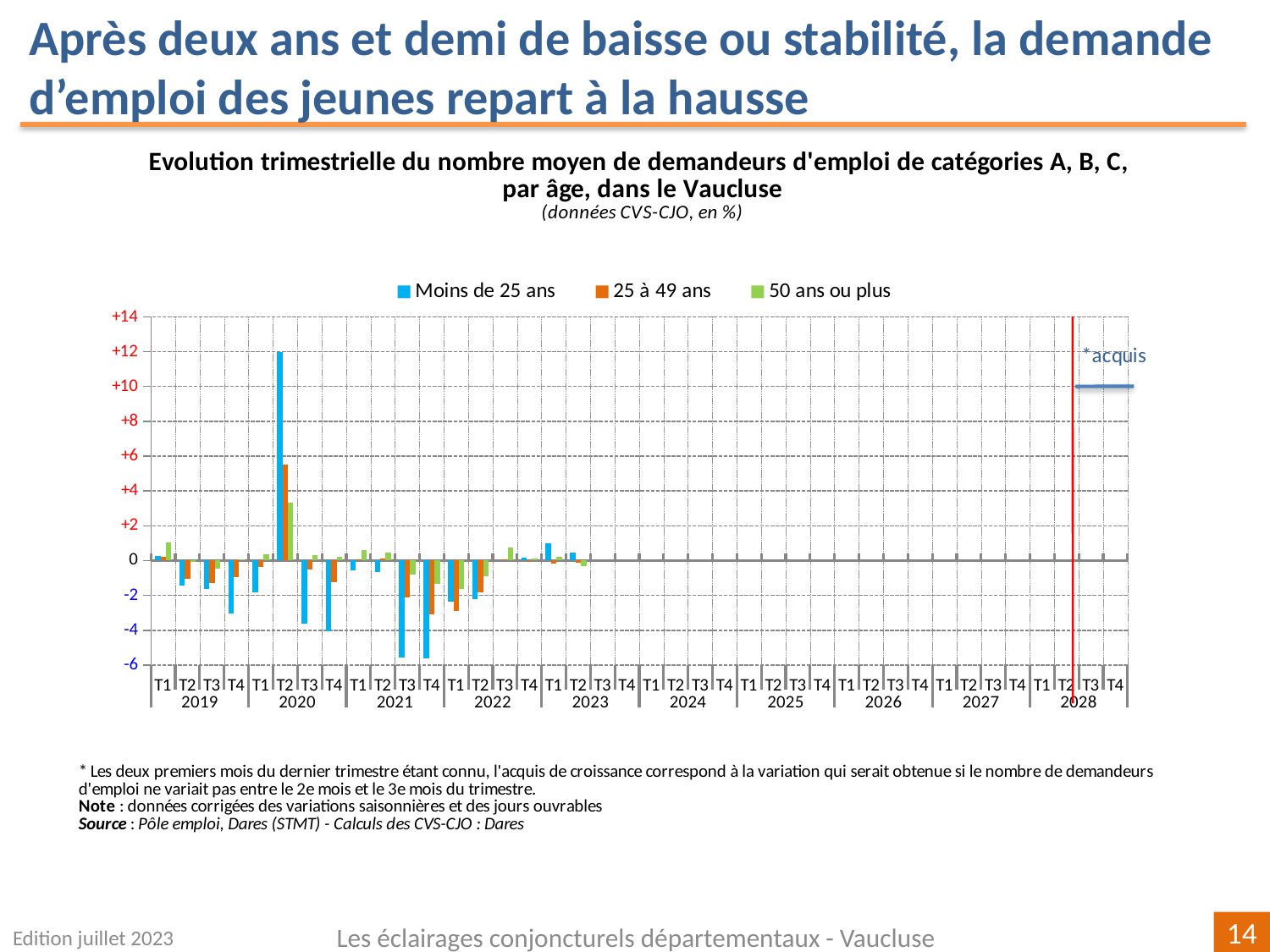
What are the three series listed in the legend? Moins de 25 ans, 25 à 49 ans, 50 ans ou plus In T2 2020, which series has the larger value: 'Moins de 25 ans' or '25 à 49 ans'? Moins de 25 ans Is the value for '25 à 49 ans' in T2 2020 greater or less than +4? greater How many series does the legend list? 3 What kind of chart is shown on the slide? bar chart How many years are labeled along the x axis? 10 Is the value for 'Moins de 25 ans' in T3 2021 greater or less than -4? less Is the value for 'Moins de 25 ans' in T2 2020 greater or less than +10? greater What annotation appears next to the red vertical line at the right of the chart? *acquis In which quarter does the 'Moins de 25 ans' series reach its highest value? T2 2020